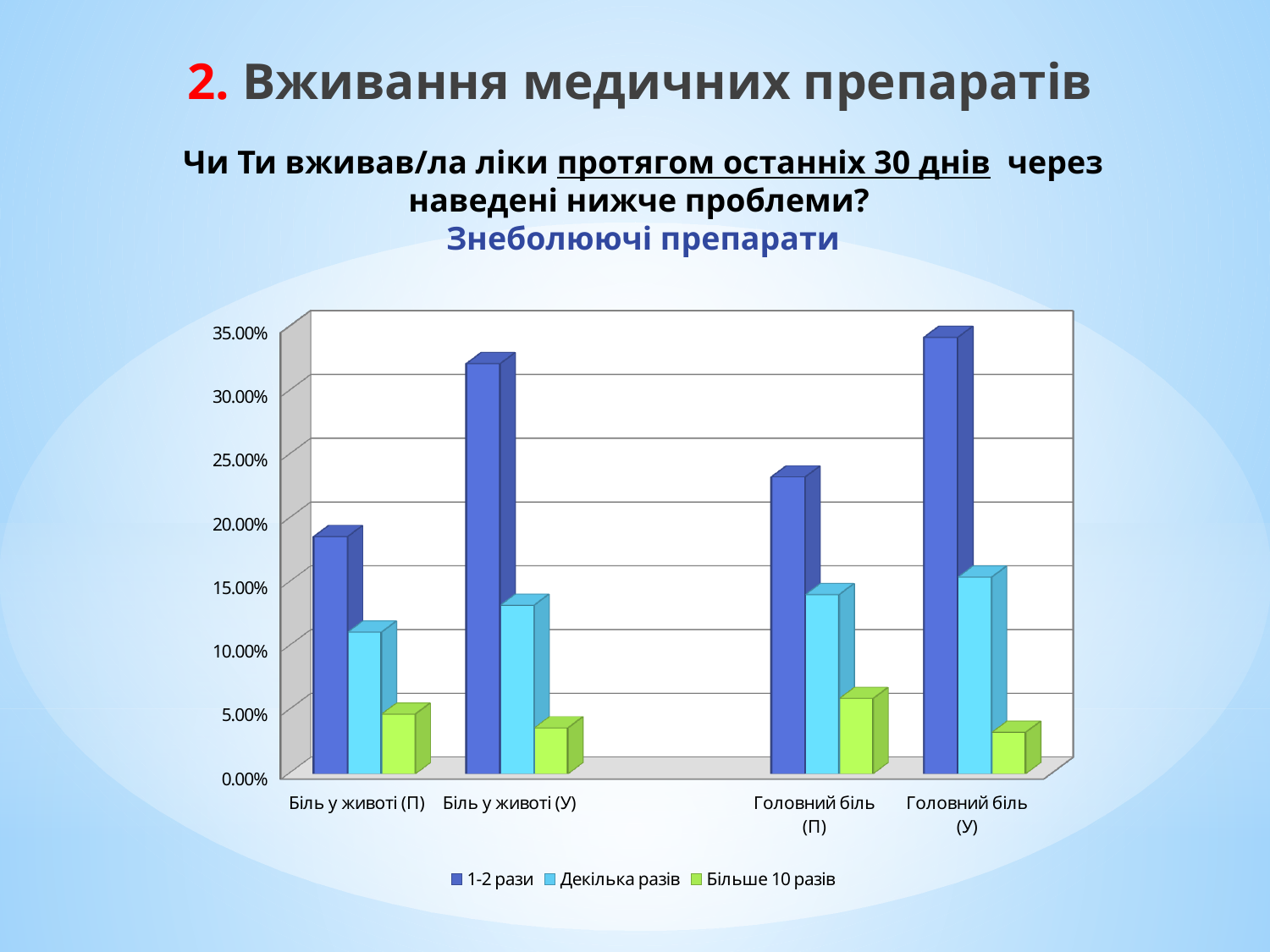
What is the subtitle of the chart shown in blue text? Знеболюючі препарати Is the value of "1-2 рази" for Біль у животі (П) greater or less than 20.00%? less How many series does the legend list? 3 How many categories are shown on the x axis? 4 Which category has the lowest value for the series "1-2 рази"? Біль у животі (П) Is the value of "1-2 рази" for Біль у животі (У) greater or less than 30.00%? greater Which category has the highest value for the series "1-2 рази"? Головний біль (У) Is the value of "1-2 рази" for Головний біль (П) greater or less than 20.00%? greater For the series "Більше 10 разів", which is larger: Головний біль (П) or Головний біль (У)? Головний біль (П) For the series "1-2 рази", which is larger: Головний біль (П) or Біль у животі (П)? Головний біль (П) What kind of chart is shown on the slide? bar chart